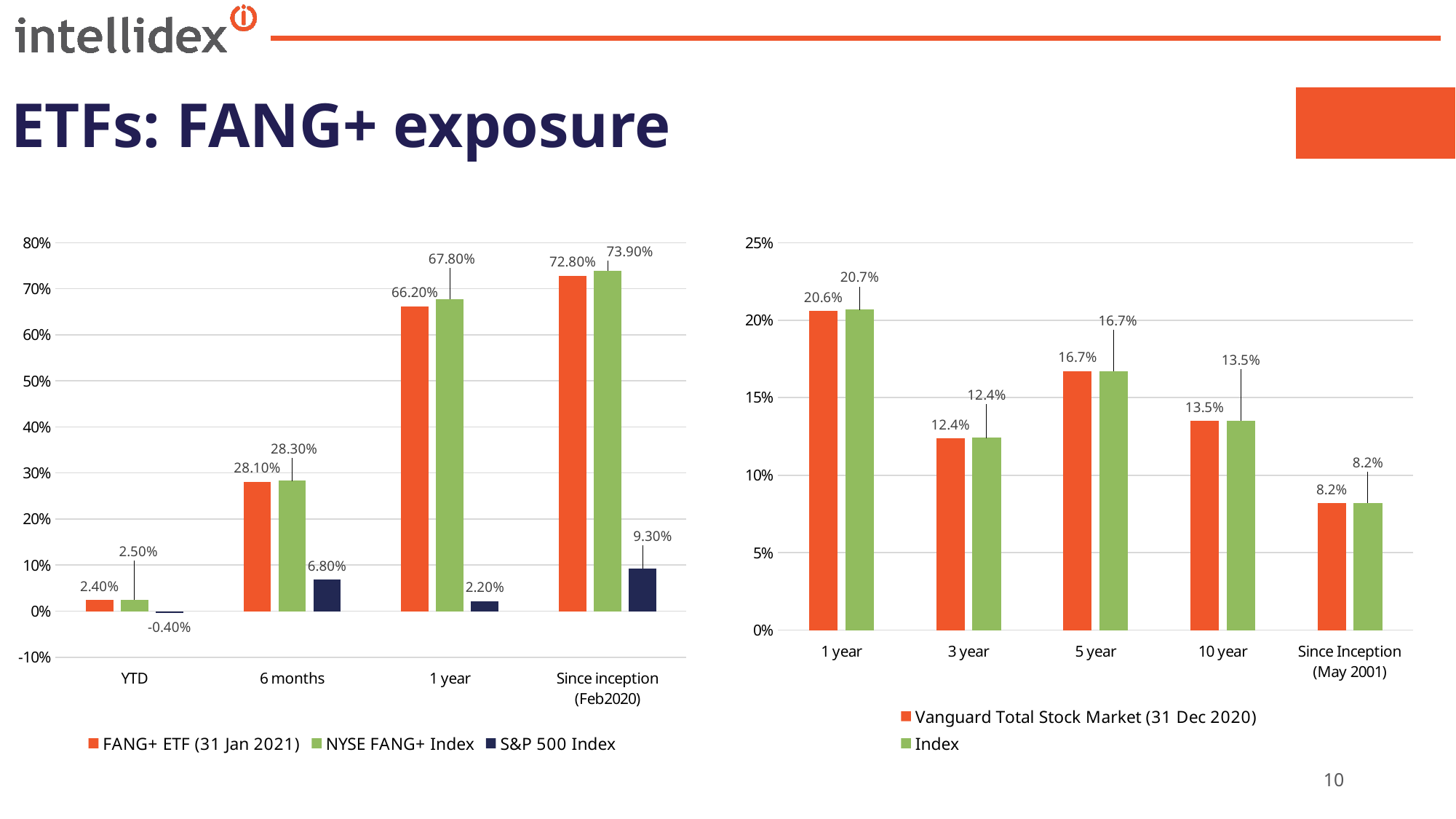
On the left chart, do the FANG+ ETF (31 Jan 2021) values rise or fall from YTD to Since inception (Feb2020)? rise On the right chart, how many categories are shown on the x axis? 5 On the right chart, which category has the lowest value for Vanguard Total Stock Market (31 Dec 2020)? Since Inception (May 2001) On the right chart, what is the value for the Index at 1 year? 20.7% On the left chart, which category has the lowest value for the S&P 500 Index? YTD What kind of chart is the right chart? bar chart On the right chart, what is the value for Vanguard Total Stock Market (31 Dec 2020) at 5 year? 16.7% On the left chart, what is the value for the FANG+ ETF (31 Jan 2021) since inception (Feb2020)? 72.80% On the left chart, what is the difference between the NYSE FANG+ Index and the S&P 500 Index at 1 year? 65.60% On the left chart, what is the value for the NYSE FANG+ Index at 1 year? 67.80% On the left chart, how many series does the legend list? 3 On the left chart, what is the value for the S&P 500 Index at 6 months? 6.80%